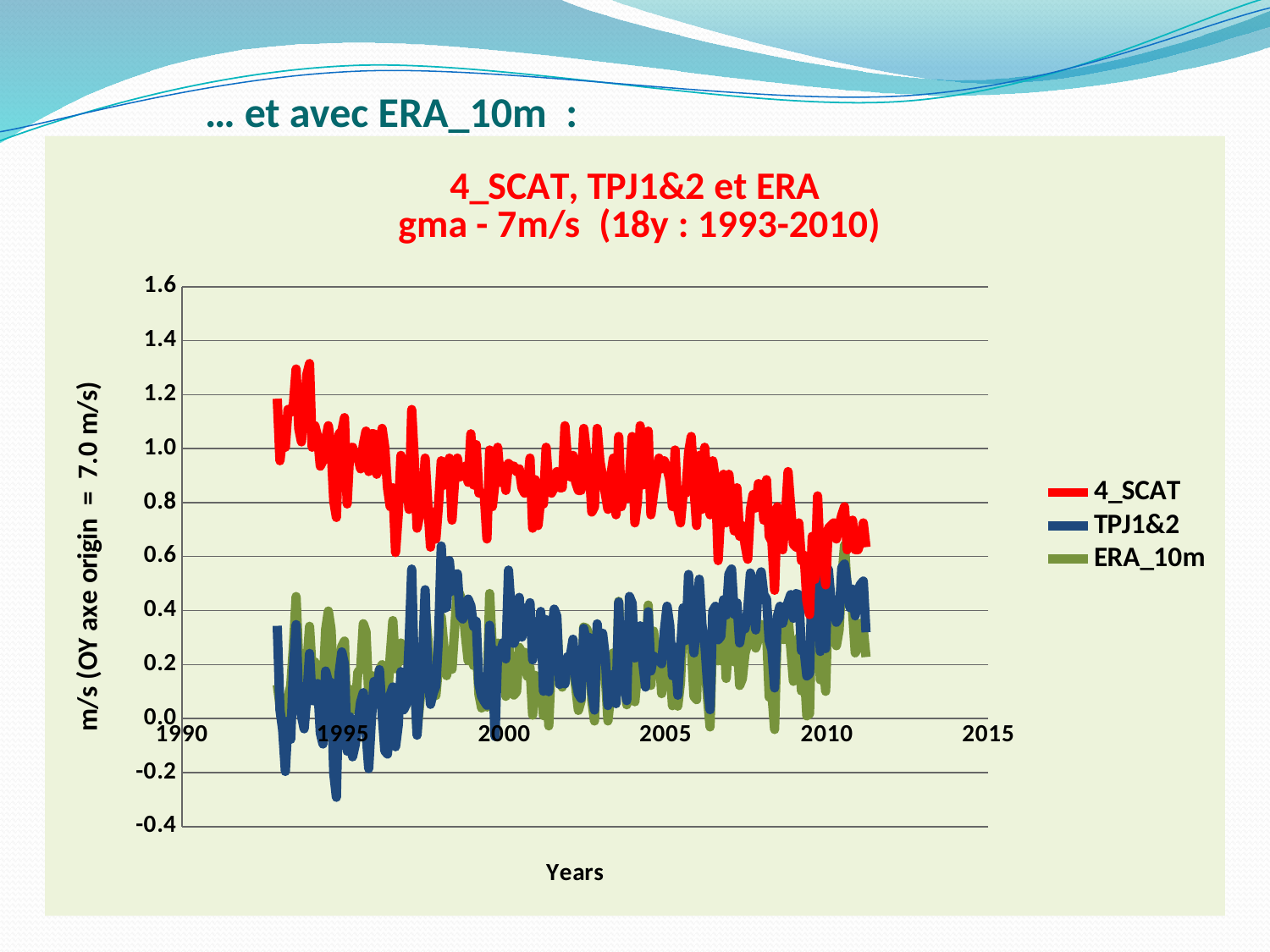
Which series has the highest values over the whole period, 4_SCAT, TPJ1&2 or ERA_10m? 4_SCAT How many series does the legend list? 3 What is the label of the x axis? Years Is the value of TPJ1&2 around 2003 greater or less than 0.8? less Which series is drawn in red? 4_SCAT What kind of chart is shown on the slide? line chart What is the title of the chart? 4_SCAT, TPJ1&2 et ERA gma - 7m/s (18y : 1993-2010) Does the 4_SCAT series generally rise or fall from 1993 to 2010? fall Is the value of ERA_10m around 2005 greater or less than 0.6? less Is the value of 4_SCAT around 1994 greater or less than 0.8? greater Around the year 2000, which series is higher, 4_SCAT or TPJ1&2? 4_SCAT